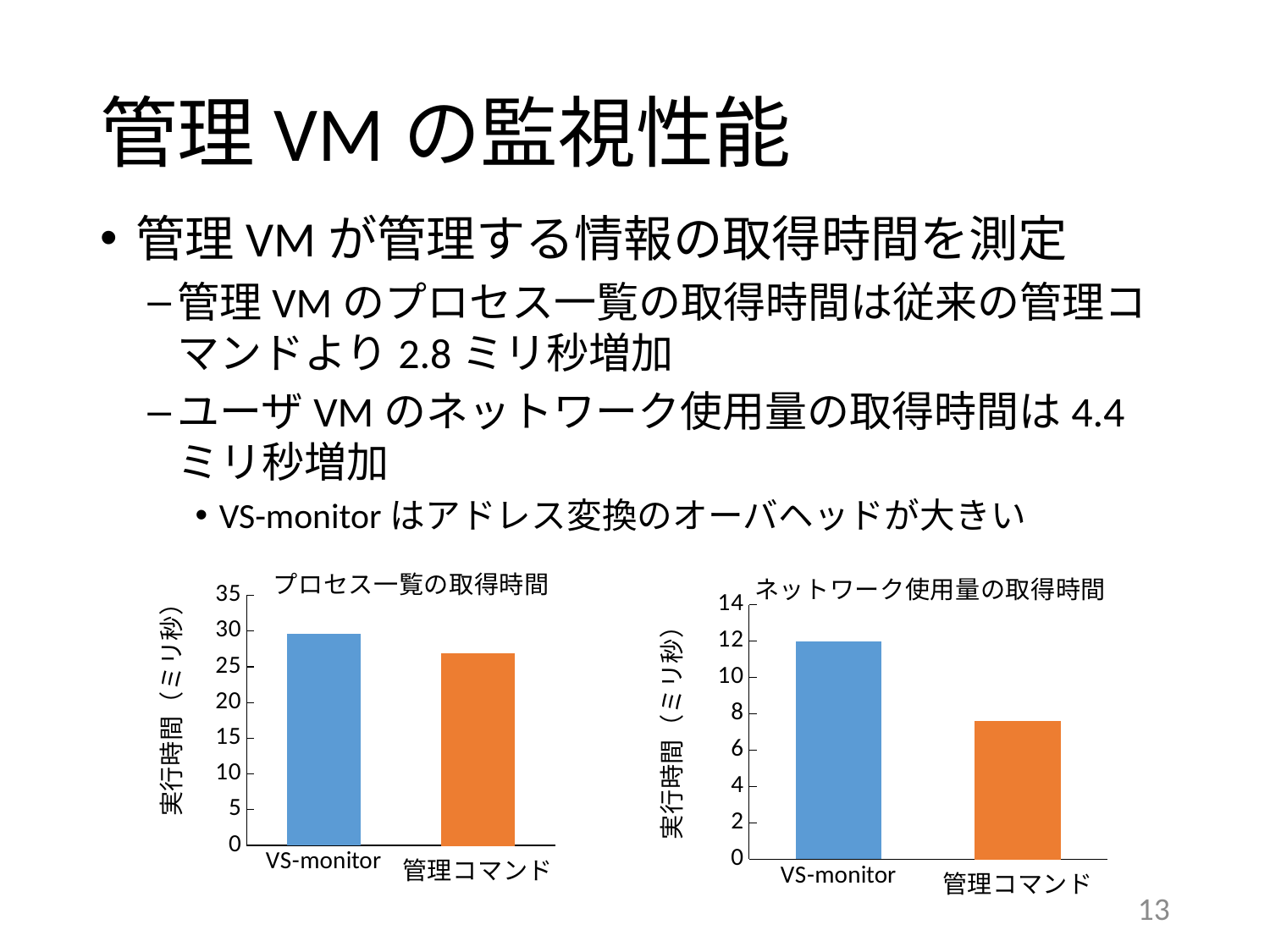
In the right chart (ネットワーク使用量の取得時間), which is larger, the value for VS-monitor or the value for 管理コマンド? VS-monitor In the right chart (ネットワーク使用量の取得時間), is the value for 管理コマンド greater or less than 6? greater In the right chart (ネットワーク使用量の取得時間), which category has the lowest value? 管理コマンド What kind of chart is the left chart titled プロセス一覧の取得時間? bar chart How many categories are shown in the right chart (ネットワーク使用量の取得時間)? 2 In the left chart (プロセス一覧の取得時間), is the value for 管理コマンド greater or less than 30? less In the right chart (ネットワーク使用量の取得時間), is the value for VS-monitor greater or less than 10? greater In the left chart (プロセス一覧の取得時間), which category has the highest value? VS-monitor What is the y-axis label of the left chart (プロセス一覧の取得時間)? 実行時間（ミリ秒） What is the title of the right chart? ネットワーク使用量の取得時間 How many categories are shown in the left chart (プロセス一覧の取得時間)? 2